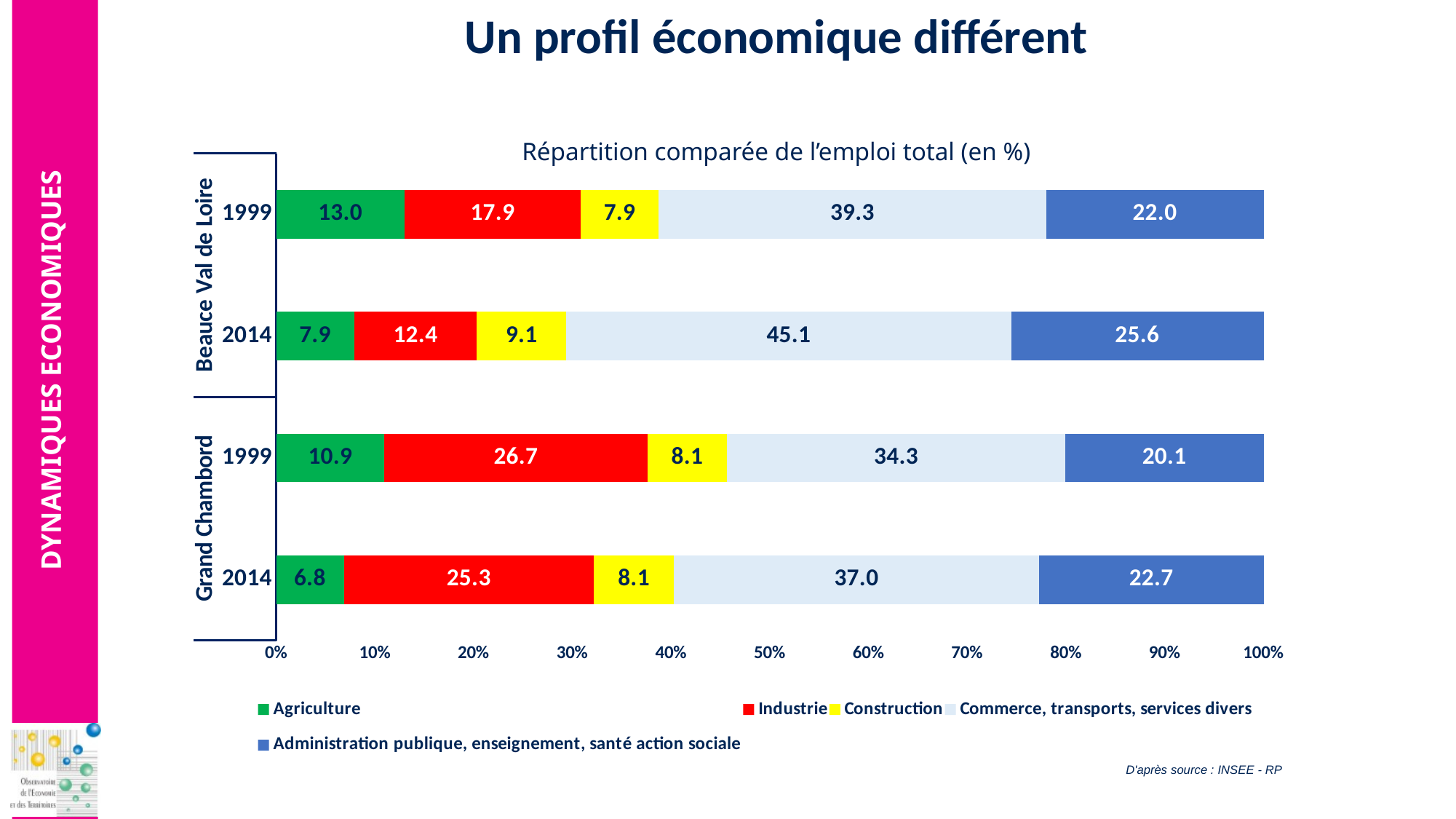
How many series does the legend list? 5 How many bars are plotted in the chart? 4 Which sector has the smallest share in the Grand Chambord 2014 bar? Agriculture Which sector has the largest share in the Beauce Val de Loire 2014 bar? Commerce, transports, services divers Did the Agriculture share for Beauce Val de Loire rise or fall between 1999 and 2014? Fall What is the value for Agriculture in the Grand Chambord 2014 bar? 6.8 Which is larger: the Industrie value for Grand Chambord 2014 or for Beauce Val de Loire 2014? Grand Chambord 2014 What is the value for Administration publique, enseignement, santé action sociale in the Grand Chambord 1999 bar? 20.1 What kind of chart is shown on the slide? Stacked bar chart What is the difference between the Industrie value for Grand Chambord 1999 and for Beauce Val de Loire 1999? 8.8 What is the value for Commerce, transports, services divers in the Beauce Val de Loire 2014 bar? 45.1 What is the value for Industrie in the Beauce Val de Loire 1999 bar? 17.9